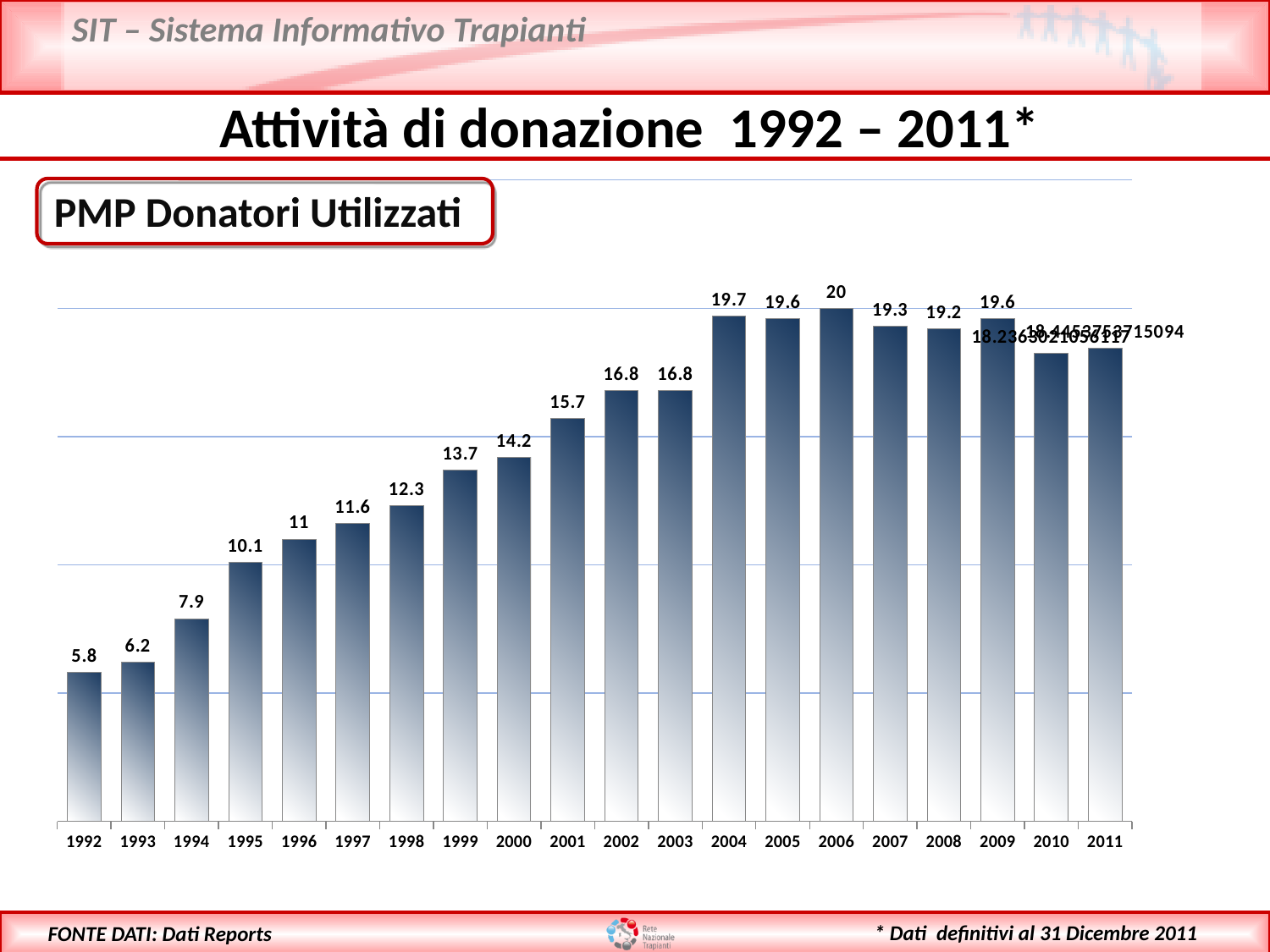
What is the value for 1992? 5.8 What is the difference between the values for 2004 and 1992? 13.9 What is the value for 2001? 15.7 How many years are shown on the x axis? 20 What is the value for 2006? 20 What kind of chart is shown? bar chart Do the values generally rise or fall from 1992 to 2006? rise Which year has the highest value? 2006 Which is larger, the value for 2007 or the value for 2008? 2007 What is the value for 1996? 11 Which year has the lowest value? 1992 What is the difference between the values for 2000 and 1999? 0.5